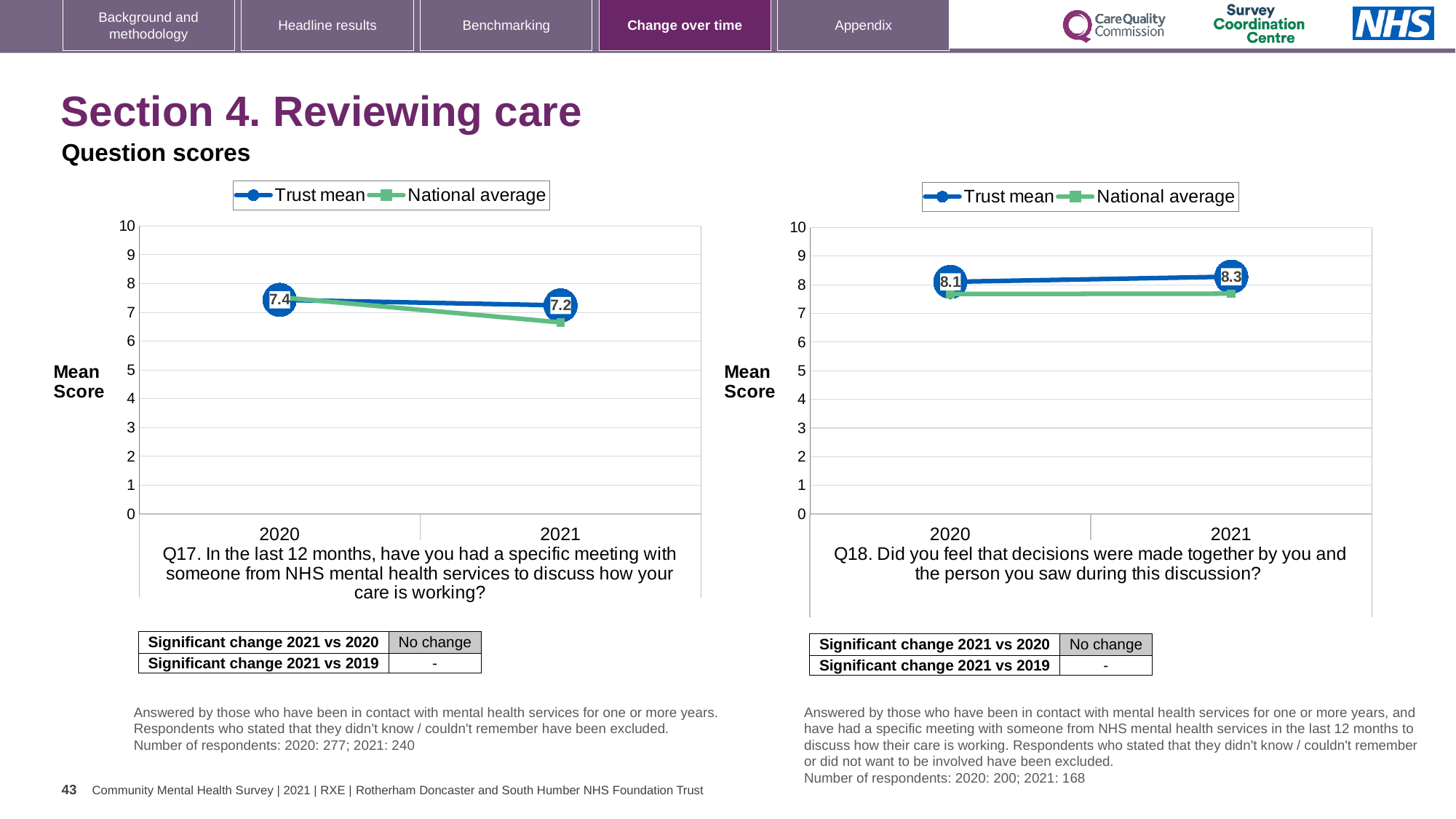
In the Q17 chart on the left, what is the Trust mean for 2020? 7.4 In the Q17 chart on the left, by how much did the Trust mean change from 2020 to 2021? 0.2 In the Q18 chart on the right, is the National average for 2020 greater or less than 7? greater In the Q17 chart on the left, does the Trust mean rise or fall from 2020 to 2021? fall In the Q18 chart on the right, what is the Trust mean for 2021? 8.3 In the Q18 chart on the right, what is the Trust mean for 2020? 8.1 What type of chart is the Q17 chart on the left? line chart In the Q18 chart on the right, what is the difference between the Trust mean in 2021 and in 2020? 0.2 In the Q17 chart on the left, is the National average for 2021 greater or less than 7? less In the Q18 chart on the right, which is higher in 2021, the Trust mean or the National average? Trust mean In the Q18 chart on the right, does the Trust mean rise or fall from 2020 to 2021? rise In the Q17 chart on the left, what is the Trust mean for 2021? 7.2